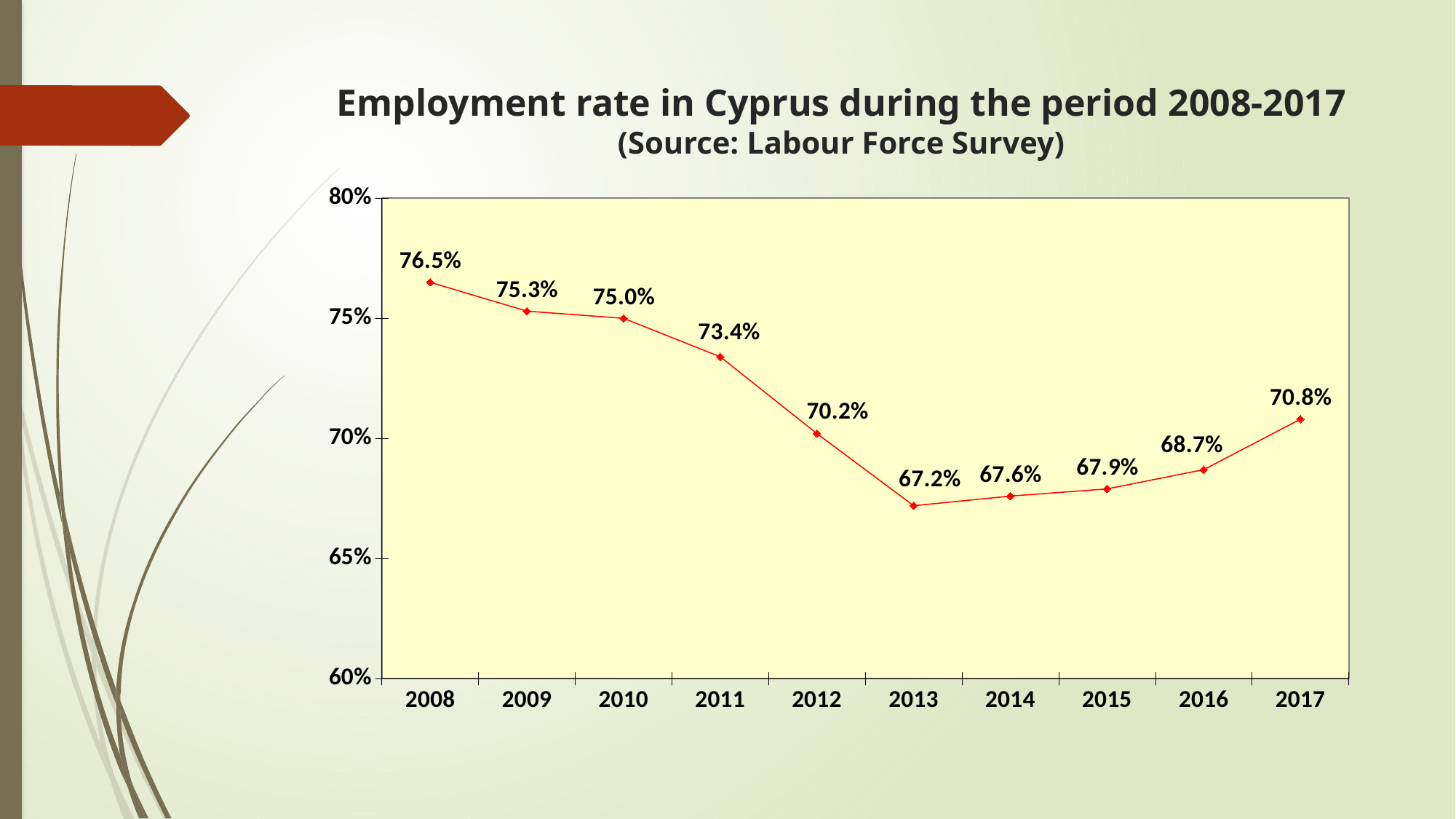
What is the difference between the employment rate in 2017 and in 2016? 2.1% Which year had the lowest employment rate? 2013 How many years are plotted on the chart? 10 What is the difference between the employment rate in 2008 and in 2013? 9.3% What was the employment rate in Cyprus in 2008? 76.5% Which year had a higher employment rate, 2011 or 2012? 2011 Is the employment rate in 2014 greater or less than 70%? less What was the employment rate in Cyprus in 2017? 70.8% Which year had the highest employment rate? 2008 What was the employment rate in Cyprus in 2013? 67.2% Did the employment rate rise or fall from 2008 to 2013? fall What kind of chart is shown on the slide? line chart